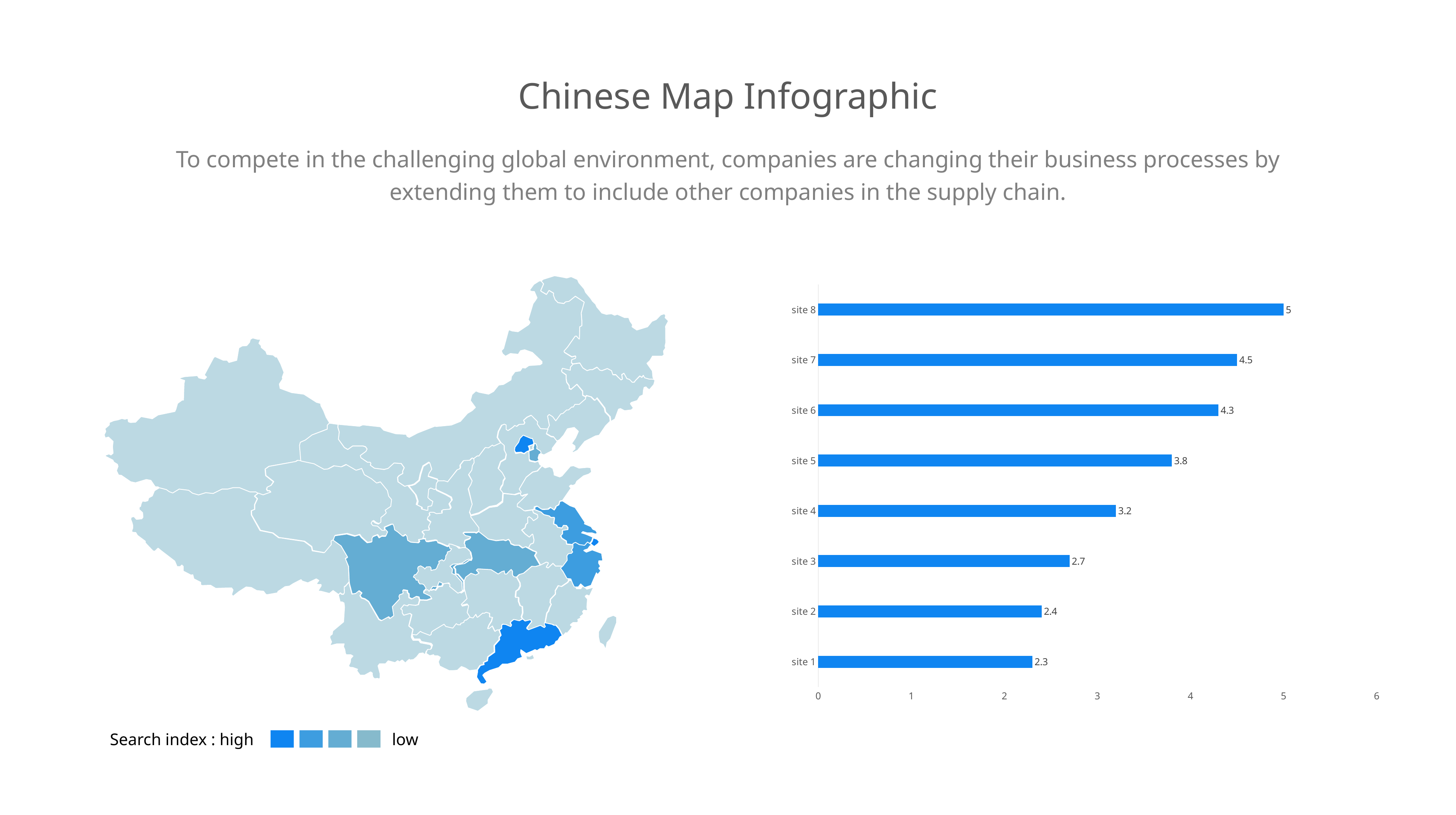
What is the difference between the values for site 2 and site 1? 0.1 What is the difference between the values for site 7 and site 4? 1.3 How many sites are shown in the bar chart? 8 Which site has the highest value in the bar chart? site 8 Is the value for site 4 greater or less than 3? greater What kind of chart is shown on the right of the slide? bar chart Which site has the lowest value in the bar chart? site 1 What is the value for site 8 in the bar chart? 5 What is the value for site 3 in the bar chart? 2.7 What is the highest tick value shown on the horizontal axis of the bar chart? 6 Which has a larger value, site 6 or site 3? site 6 What is the value for site 5 in the bar chart? 3.8